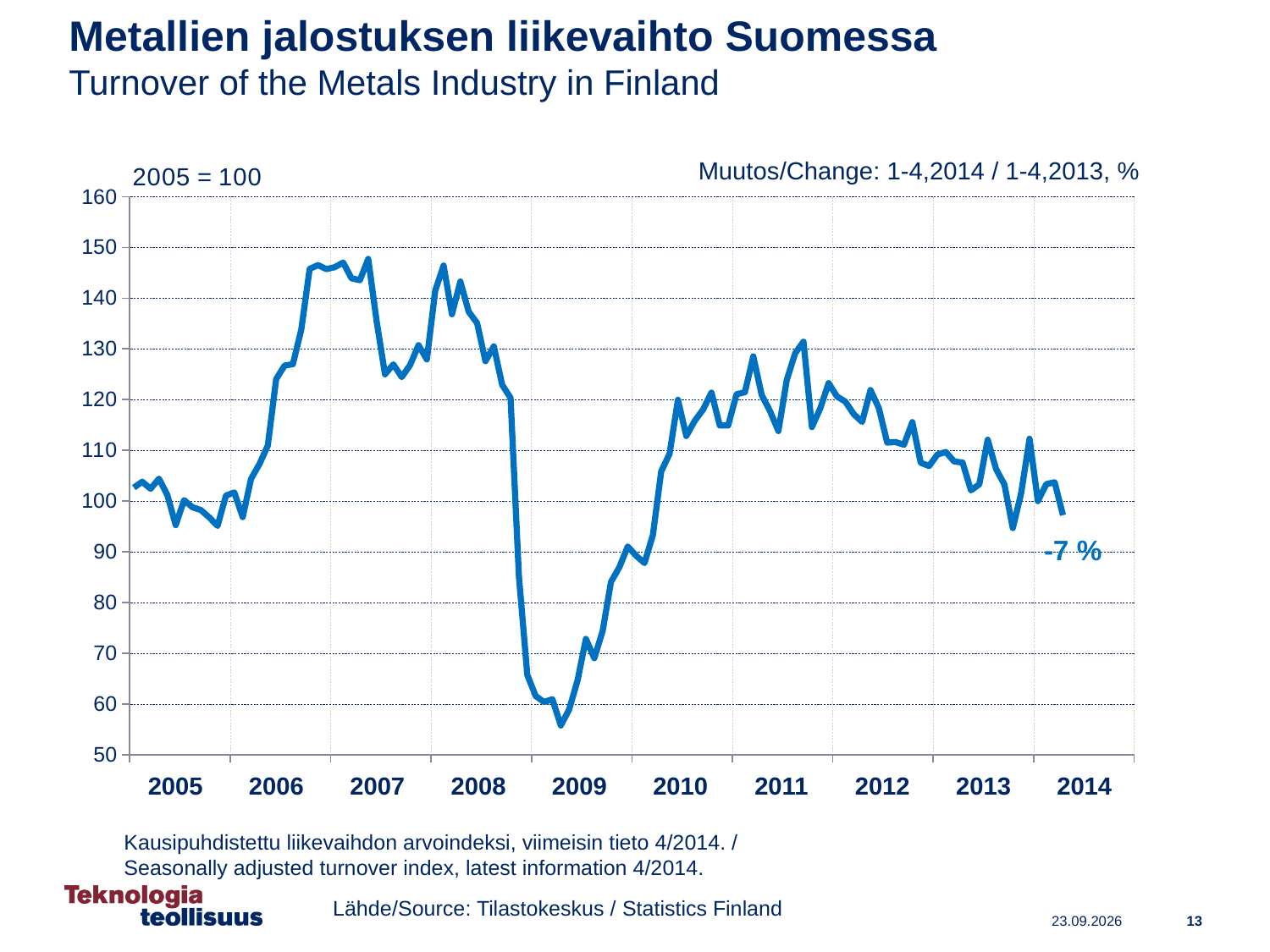
Is the value at the end of the line in 2014 greater or less than 110? less How many year labels are shown on the x axis? 10 Is the highest value on the chart greater or less than 140? greater Do the values generally rise or fall from 2011 to 2014? fall What kind of chart is shown on the slide? line chart What source is given for the chart data? Tilastokeskus / Statistics Finland Do the values generally rise or fall from 2005 to 2007? rise In which year does the line reach its lowest point? 2009 Which year is used as the base year (index = 100) for the chart? 2005 Is the value at the start of 2005 greater or less than 110? less What is the change for 1-4,2014 compared with 1-4,2013 shown on the chart? -7 %